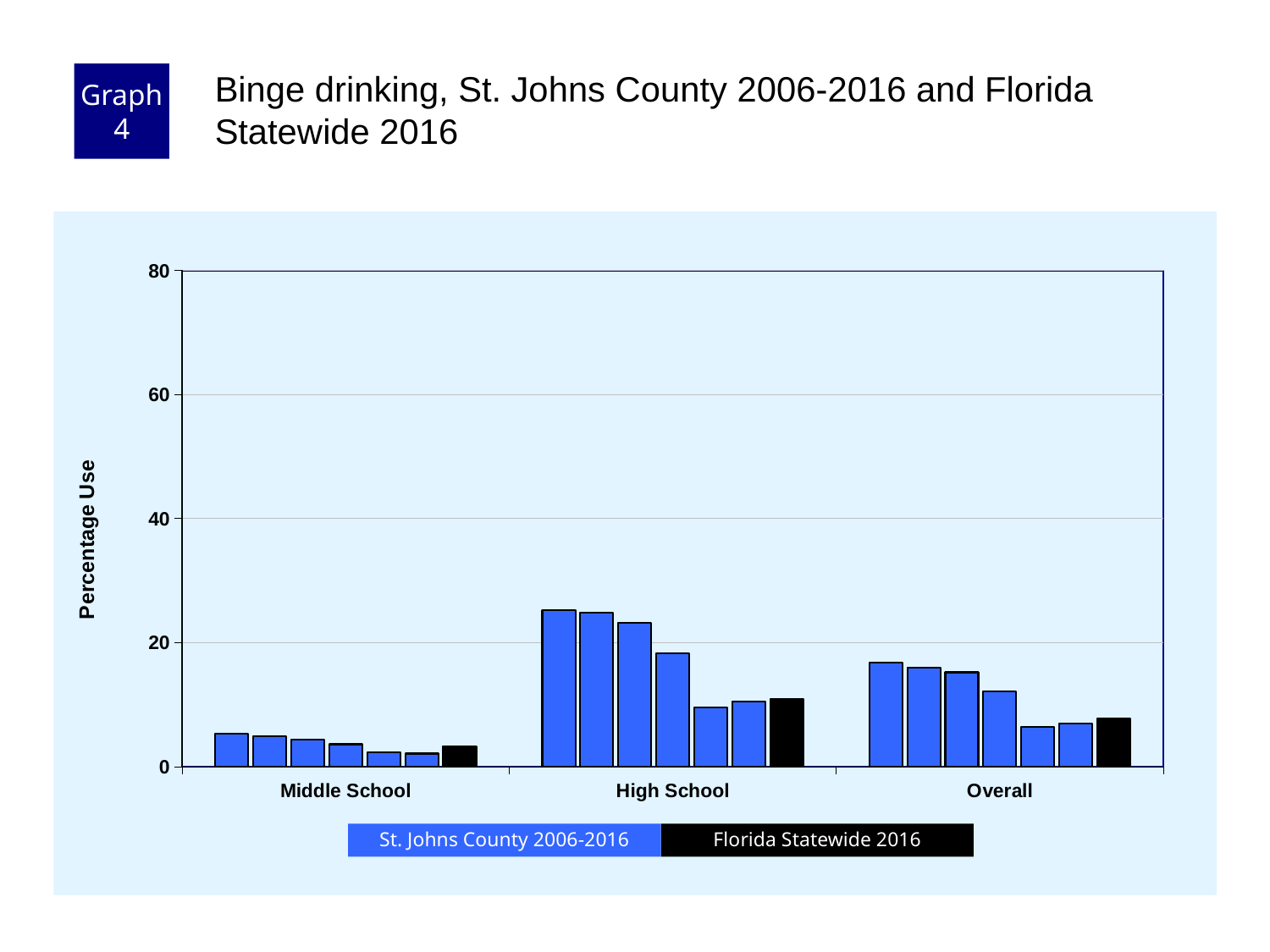
How many categories are shown on the x axis of the chart? 3 Is the value of the tallest High School bar greater or less than 20? greater What is the label on the y axis of the chart? Percentage Use What kind of chart is shown on the slide? bar chart Is the Florida Statewide 2016 value for Middle School greater or less than 20? less Is the Florida Statewide 2016 value for High School larger or smaller than the Florida Statewide 2016 value for Middle School? larger Within the High School category, do the St. Johns County 2006-2016 bars rise or fall from left to right? fall Is the Florida Statewide 2016 value for High School greater or less than 20? less Which category has the lowest bars in the chart? Middle School What colour are the Florida Statewide 2016 bars in the chart? black How many series does the chart's legend list? 2 Which category has the highest bars in the chart? High School